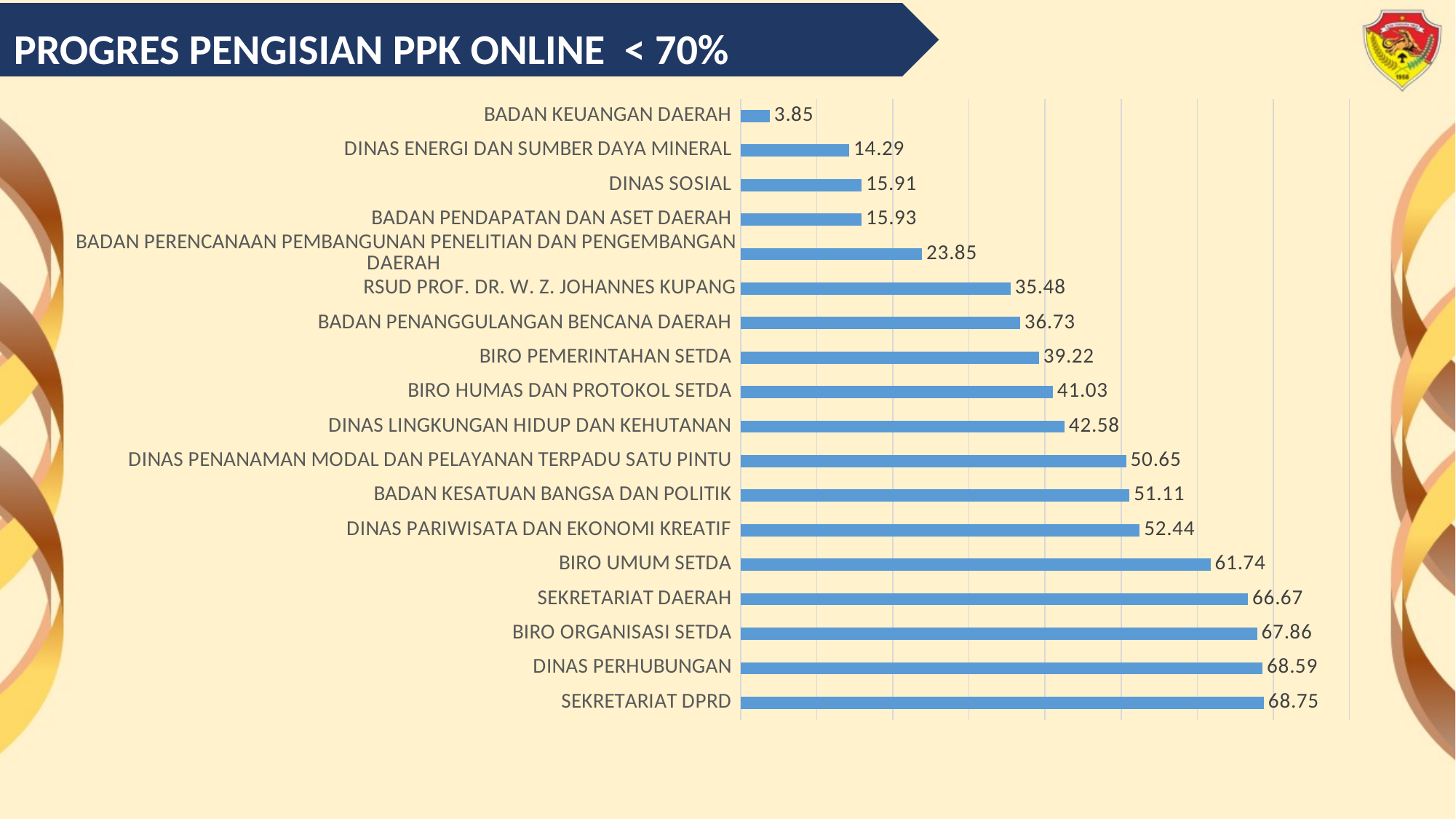
How many categories are shown in the chart? 18 What is the difference between the values for SEKRETARIAT DPRD and BADAN KEUANGAN DAERAH? 64.90 What is the value for BIRO HUMAS DAN PROTOKOL SETDA? 41.03 What is the value for DINAS PERHUBUNGAN? 68.59 What is the difference between the values for BIRO UMUM SETDA and DINAS LINGKUNGAN HIDUP DAN KEHUTANAN? 19.16 Which is larger, the value for BIRO PEMERINTAHAN SETDA or the value for DINAS ENERGI DAN SUMBER DAYA MINERAL? BIRO PEMERINTAHAN SETDA Which is larger, the value for DINAS SOSIAL or the value for BADAN PENANGGULANGAN BENCANA DAERAH? BADAN PENANGGULANGAN BENCANA DAERAH Which category has the lowest value? BADAN KEUANGAN DAERAH What is the value for RSUD PROF. DR. W. Z. JOHANNES KUPANG? 35.48 What is the title of the slide? PROGRES PENGISIAN PPK ONLINE < 70% What is the value for BADAN KEUANGAN DAERAH? 3.85 What kind of chart is shown on the slide? Bar chart